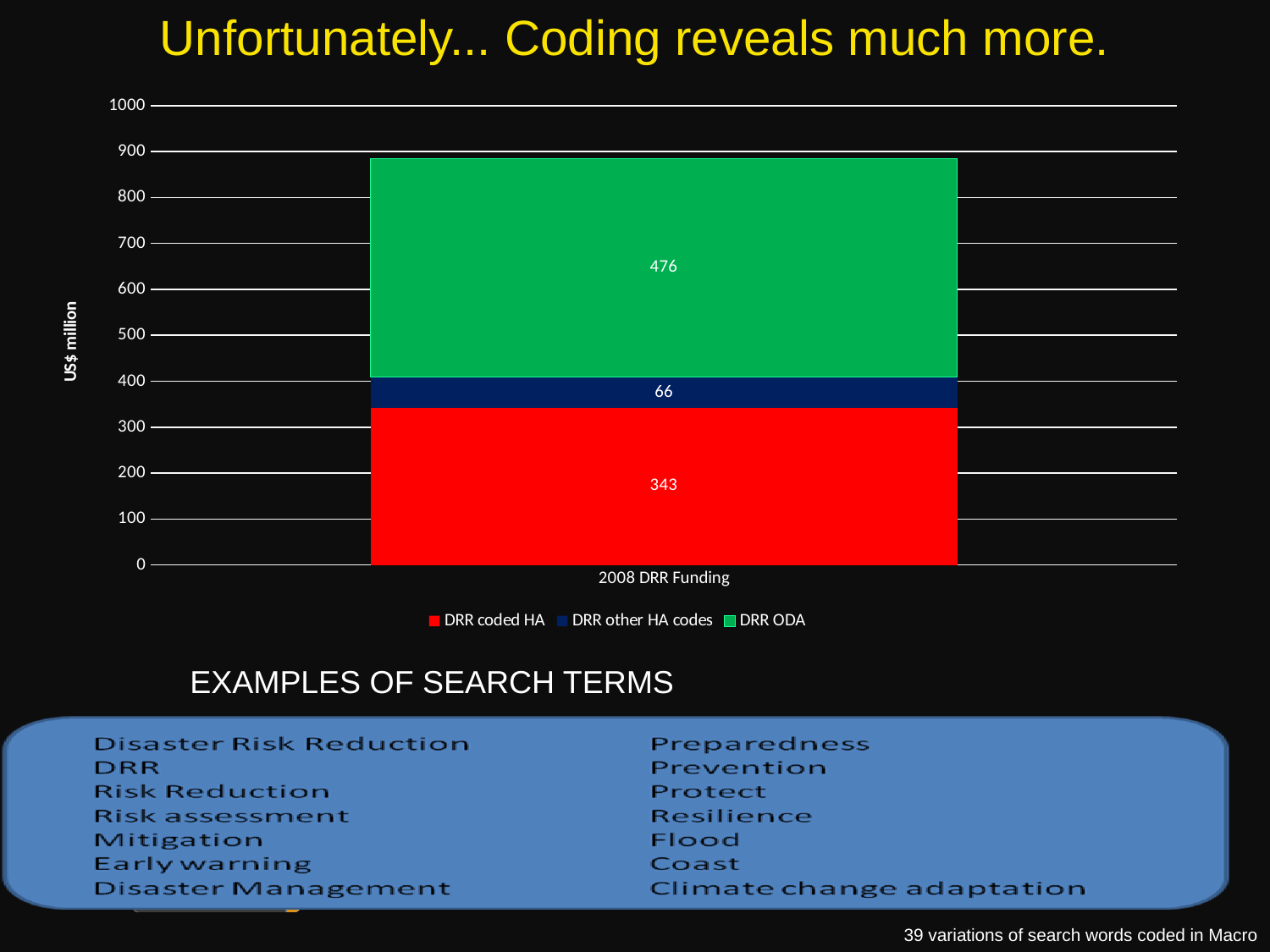
Which series has the smallest value in the 2008 DRR Funding bar? DRR other HA codes What is the value for DRR other HA codes in the 2008 DRR Funding bar? 66 What is the value for DRR coded HA in the 2008 DRR Funding bar? 343 How many series does the legend list? 3 What is the total of the stacked 2008 DRR Funding bar? 885 Which series has the largest value in the 2008 DRR Funding bar? DRR ODA What is the difference between the DRR ODA value and the DRR coded HA value? 133 What is the label of the y axis? US$ million Which is larger, the DRR coded HA value or the DRR other HA codes value? DRR coded HA What kind of chart is shown on the slide? Stacked bar chart How many categories are shown on the x axis? 1 What is the value for DRR ODA in the 2008 DRR Funding bar? 476